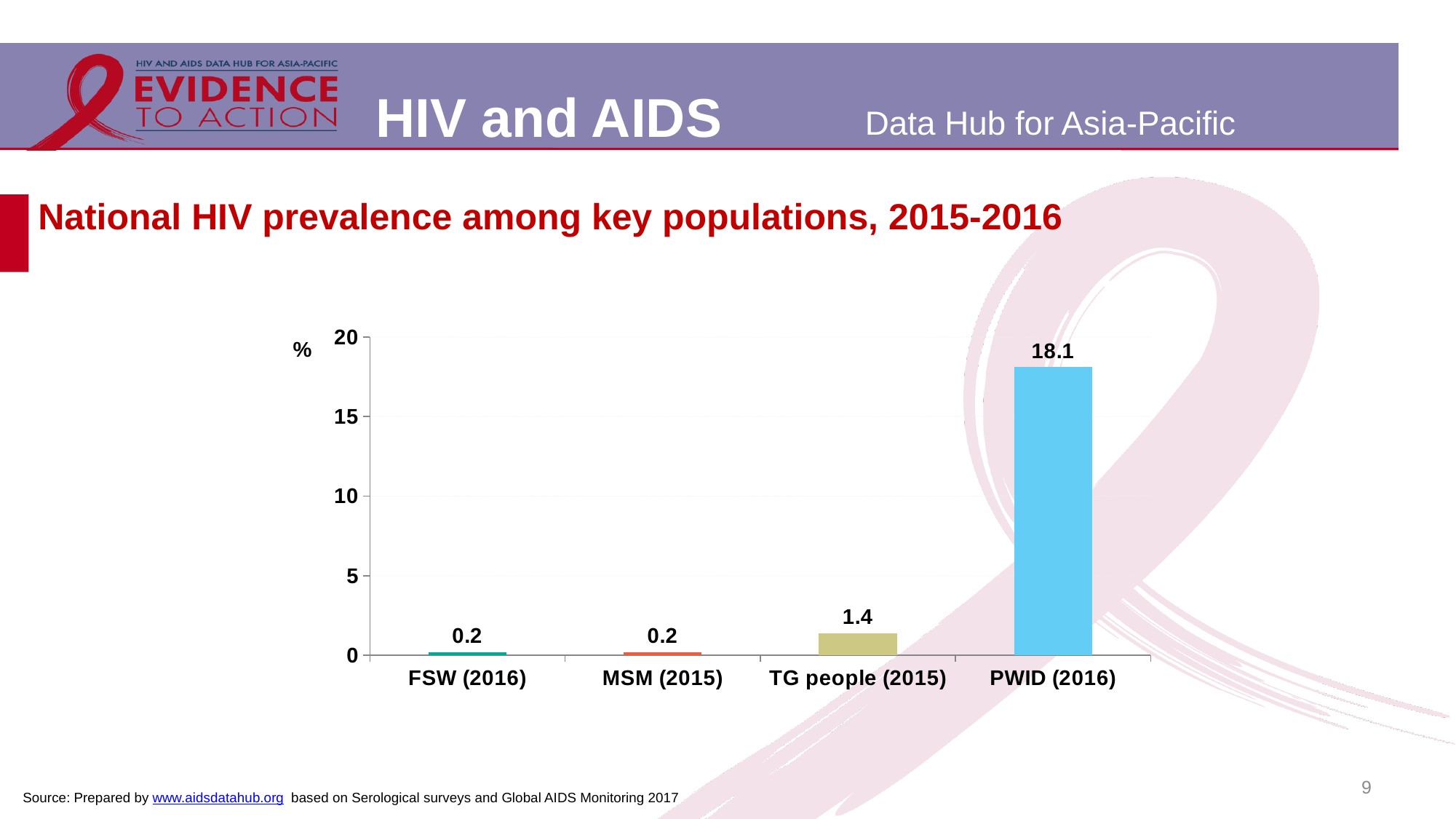
What is the difference between the values for PWID (2016) and TG people (2015)? 16.7 What kind of chart is shown on the slide? Bar chart What is the difference between the values for TG people (2015) and MSM (2015)? 1.2 What is the HIV prevalence value shown for TG people (2015)? 1.4 Which key population has the highest HIV prevalence on the chart? PWID (2016) What is the HIV prevalence value shown for FSW (2016)? 0.2 How many key population categories are shown on the chart? 4 Is the value for PWID (2016) greater or less than 15? greater What is the HIV prevalence value shown for MSM (2015)? 0.2 What is the HIV prevalence value shown for PWID (2016)? 18.1 Which is larger, the value for TG people (2015) or the value for FSW (2016)? TG people (2015) What is the title of the chart on the slide? National HIV prevalence among key populations, 2015-2016